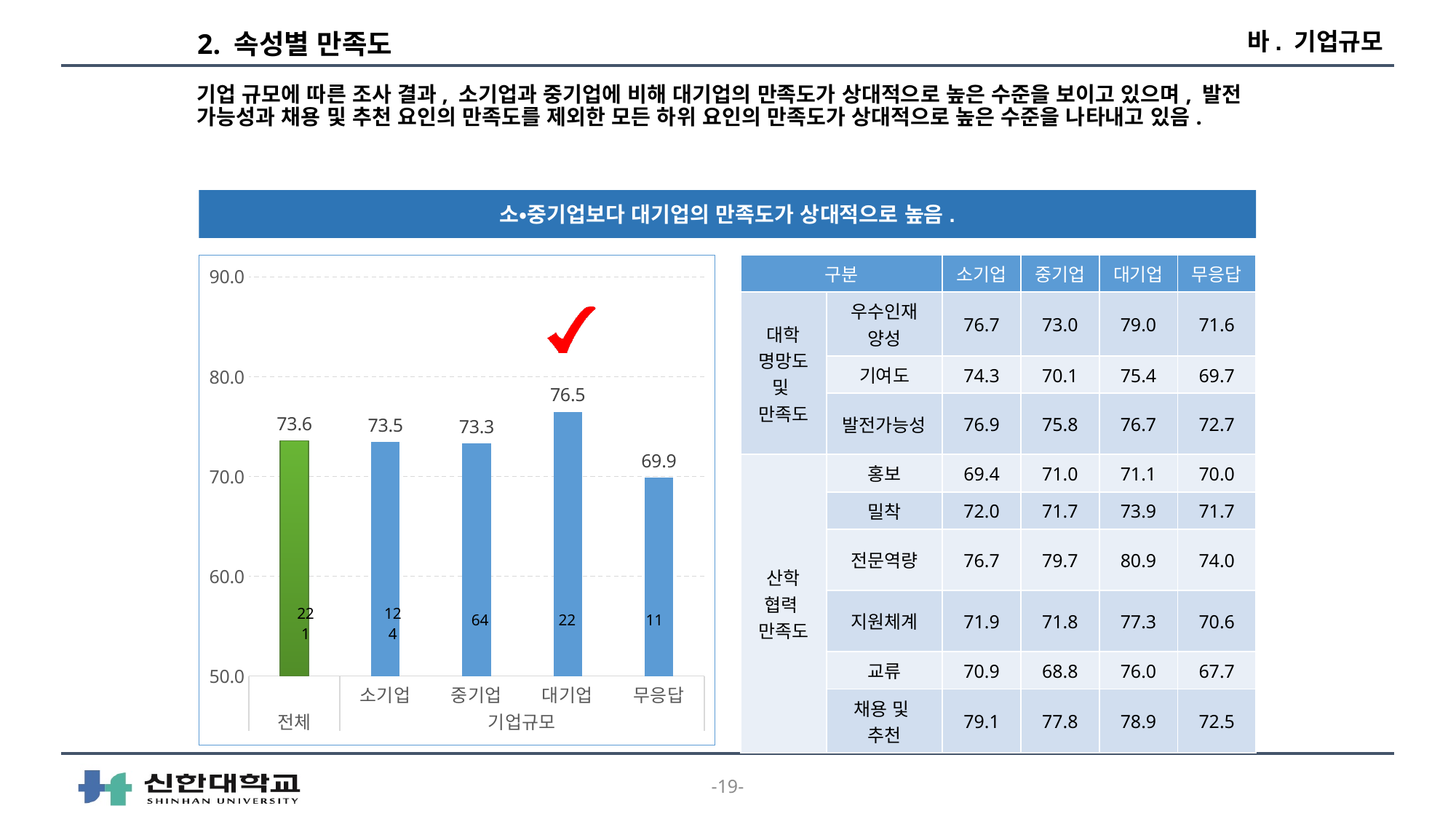
What type of chart is shown on the slide? bar chart What is the value shown for 중기업 in the bar chart? 73.3 What is the satisfaction value shown for 대기업 in the bar chart? 76.5 Is the value for 무응답 in the bar chart greater or less than 70.0? less What is the value shown for 전체 in the bar chart? 73.6 Which has a larger value in the bar chart, 대기업 or 무응답? 대기업 Which category has the lowest value in the bar chart? 무응답 What is the value shown for 무응답 in the bar chart? 69.9 What is the difference between the values for 대기업 and 무응답 in the bar chart? 6.6 What is the difference between the values for 대기업 and 소기업 in the bar chart? 3.0 How many bars are shown in the bar chart? 5 Which category has the highest value in the bar chart? 대기업